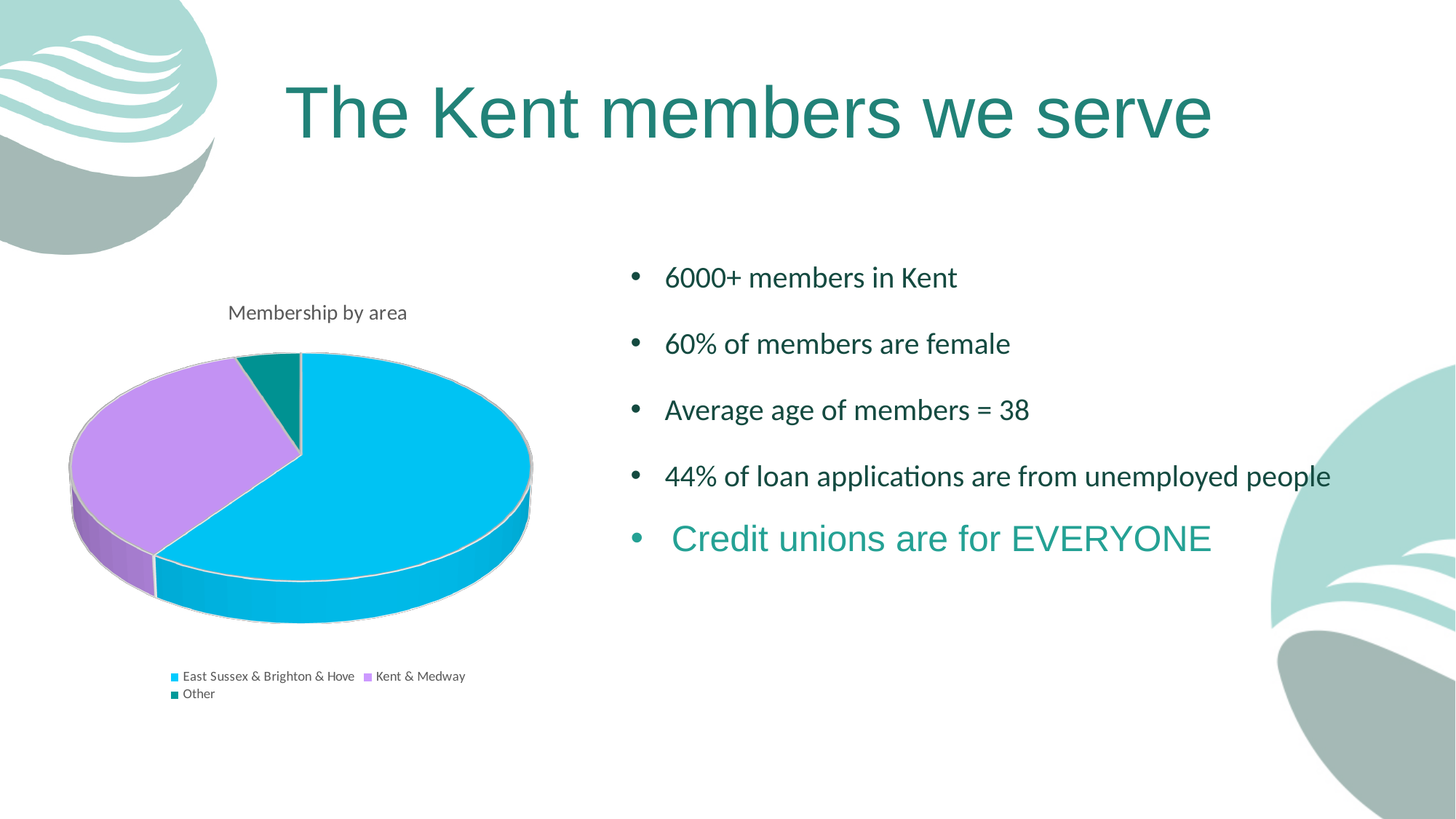
Which legend entry is shown in purple? Kent & Medway What is the title of the chart? Membership by area How many categories does the pie chart show? 3 Which has a larger share of membership, East Sussex & Brighton & Hove or Kent & Medway? East Sussex & Brighton & Hove Which area has the largest share of membership in the pie chart? East Sussex & Brighton & Hove What kind of chart is shown on the slide? pie chart Which has a larger share of membership, Kent & Medway or Other? Kent & Medway Which area has the smallest share of membership in the pie chart? Other